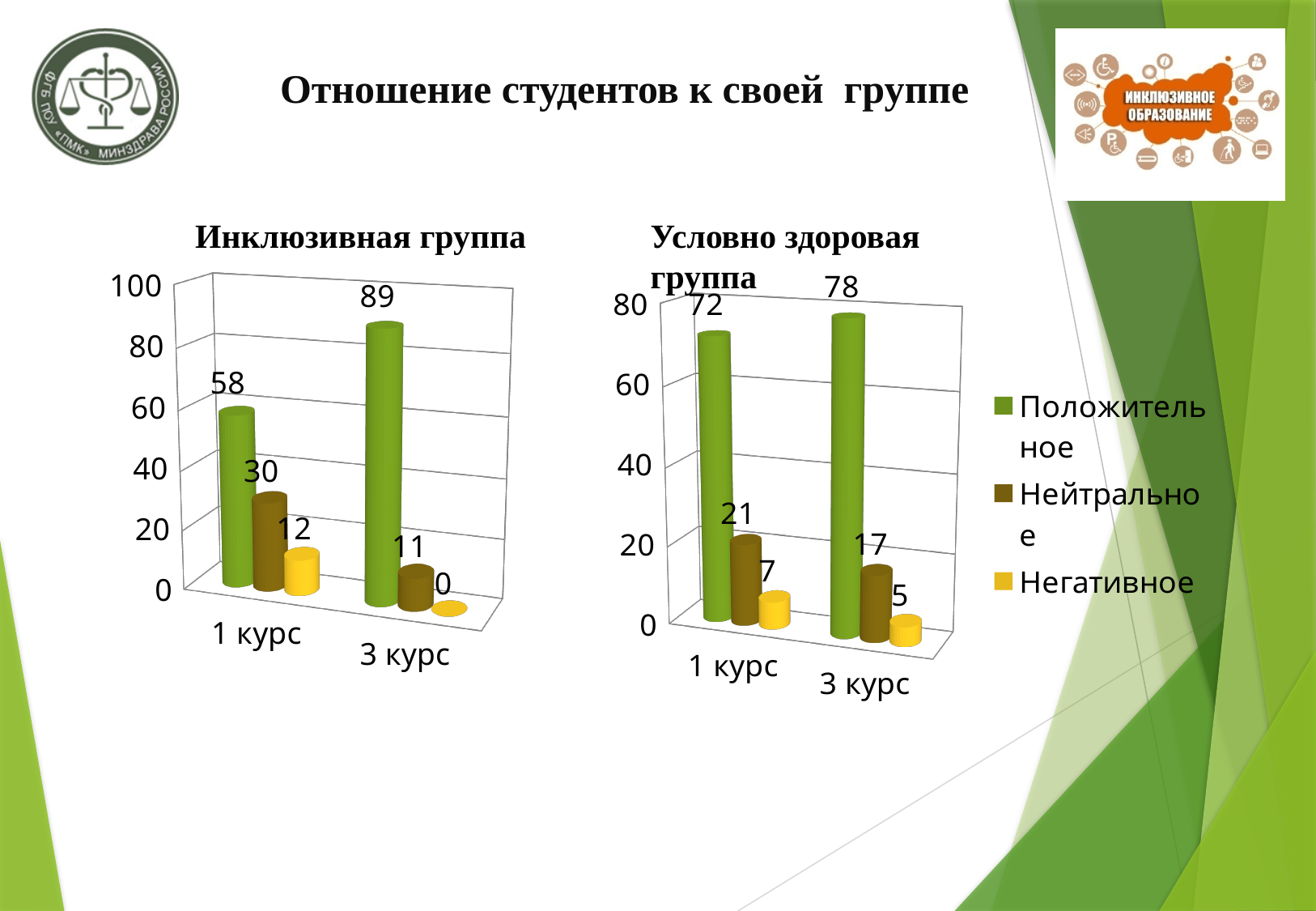
How many series does the legend list? 3 In the 'Инклюзивная группа' chart, what is the difference between the Положительное values for 3 курс and 1 курс? 31 In the 'Инклюзивная группа' chart, what is the value for Негативное for 3 курс? 0 In the 'Условно здоровая группа' chart, does the Положительное value rise or fall from 1 курс to 3 курс? Rise In the 'Условно здоровая группа' chart, what is the value for Нейтральное for 1 курс? 21 In the 'Инклюзивная группа' chart, what is the value for Положительное for 1 курс? 58 In the 'Условно здоровая группа' chart, what is the difference between the Нейтральное values for 1 курс and 3 курс? 4 In the 'Инклюзивная группа' chart, which category and series has the highest value? Положительное, 3 курс Which is larger: the Негативное value for 1 курс in the 'Инклюзивная группа' chart or in the 'Условно здоровая группа' chart? Инклюзивная группа What kind of chart is the 'Инклюзивная группа' chart? Bar chart In the 'Условно здоровая группа' chart, what is the value for Положительное for 3 курс? 78 In the 'Условно здоровая группа' chart, which series has the lowest value for 3 курс? Негативное